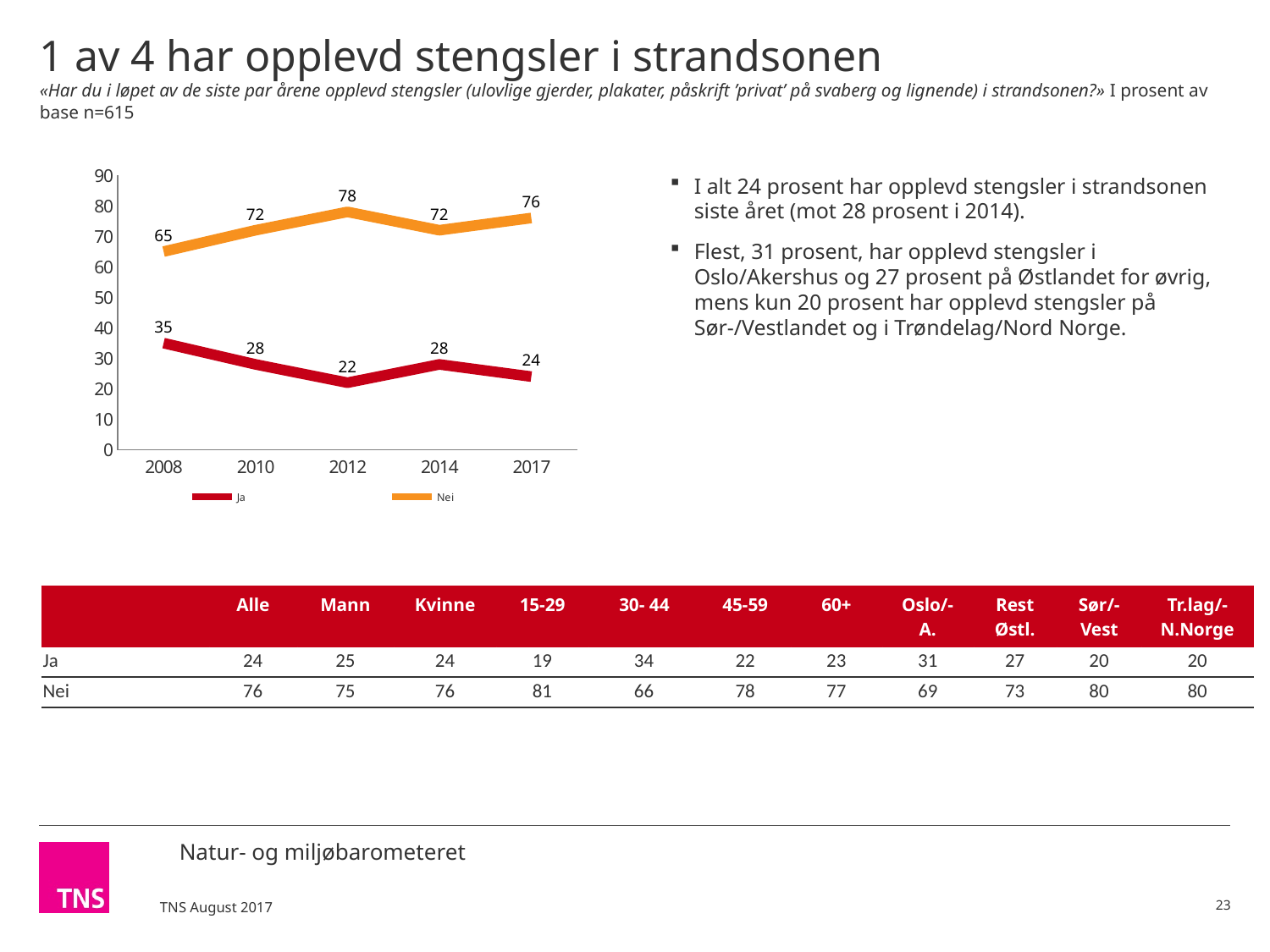
Which colour is used for the Nei series in the chart? Orange What is the difference between the Nei and Ja values in 2017? 52 How many series does the legend list? 2 In which year is the Nei series at its highest? 2012 What kind of chart is shown on the slide? Line chart Which is larger in 2014, the Ja value or the Nei value? Nei In which year is the Ja series at its lowest? 2012 By how much did the Ja value change from 2008 to 2017? 11 How many years are shown on the x axis of the chart? 5 What is the value of the Ja series in 2008? 35 What is the value of the Nei series in 2012? 78 What is the value of the Ja series in 2017? 24